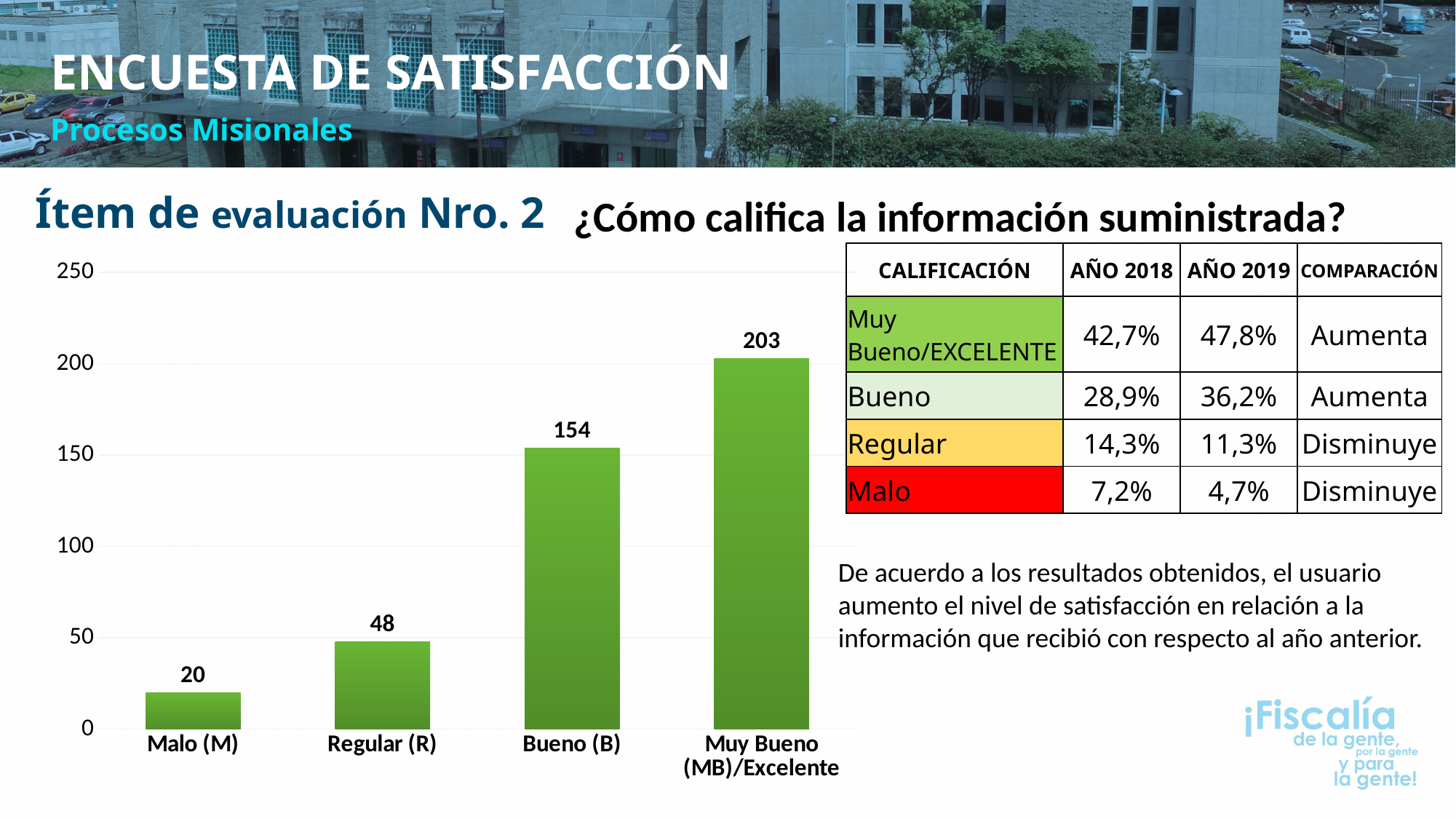
Which is larger, the value for Regular (R) or the value for Bueno (B)? Bueno (B) What is the value for Regular (R)? 48 What is the difference between the values for Muy Bueno (MB)/Excelente and Bueno (B)? 49 Which category has the lowest value? Malo (M) Do the values rise or fall from left to right along the x axis? rise Which category has the highest value? Muy Bueno (MB)/Excelente What is the value for Muy Bueno (MB)/Excelente? 203 What is the difference between the values for Regular (R) and Malo (M)? 28 What kind of chart is shown on the slide? bar chart What is the value for Bueno (B)? 154 How many categories are shown on the x axis of the chart? 4 What is the value for Malo (M)? 20